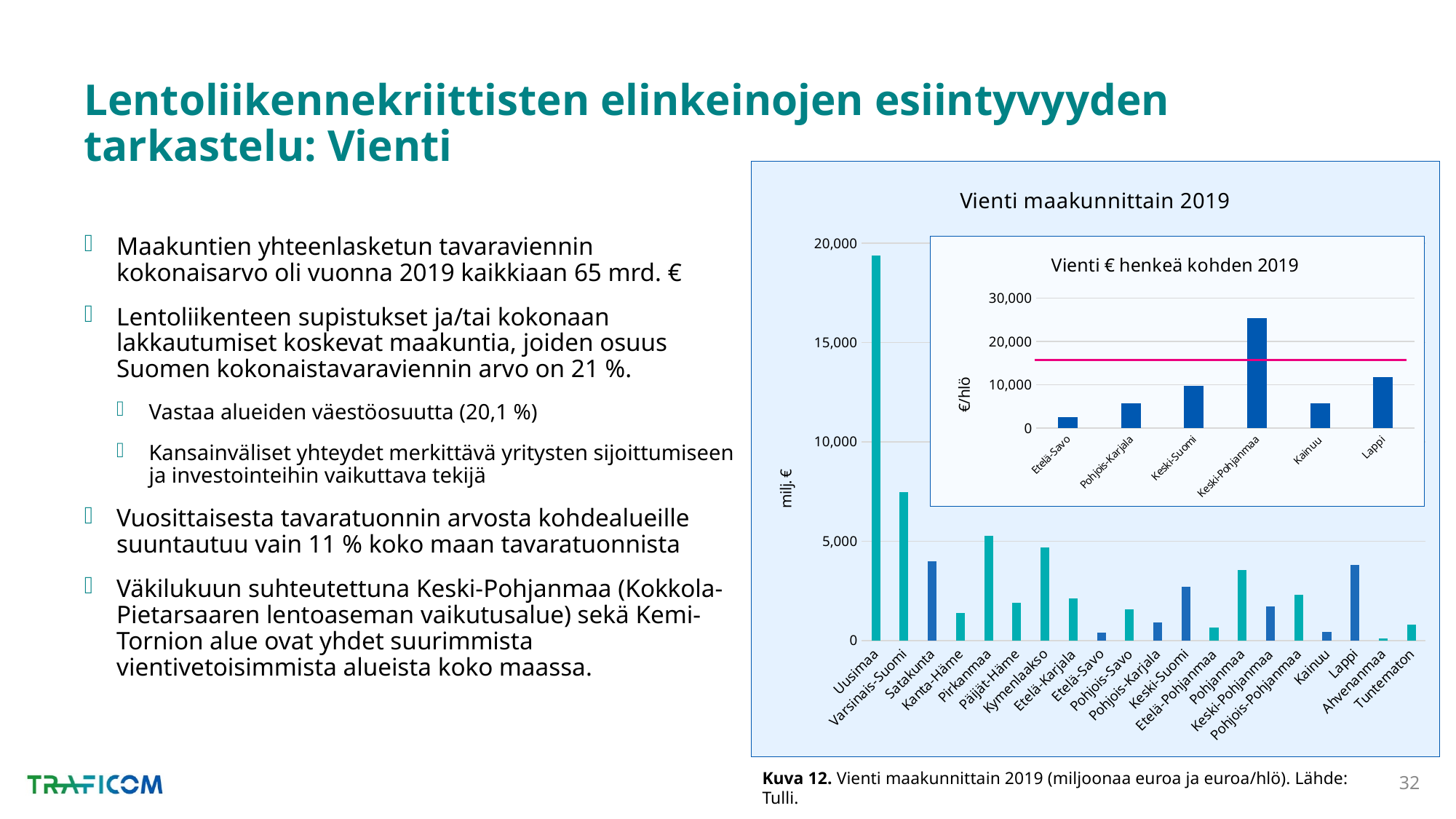
In the chart titled 'Vienti maakunnittain 2019', is the value for Varsinais-Suomi greater or less than 5,000? greater In the chart titled 'Vienti maakunnittain 2019', which region has the lowest value? Ahvenanmaa How many regions are shown in the inset chart titled 'Vienti € henkeä kohden 2019'? 6 What kind of chart is 'Vienti maakunnittain 2019'? bar chart In the inset chart titled 'Vienti € henkeä kohden 2019', which region has the highest value? Keski-Pohjanmaa In the chart titled 'Vienti maakunnittain 2019', which region has the highest value? Uusimaa In the chart titled 'Vienti maakunnittain 2019', is the value for Uusimaa greater or less than 15,000? greater In the inset chart titled 'Vienti € henkeä kohden 2019', is the value for Keski-Pohjanmaa greater or less than 20,000? greater How many regions (categories) are shown on the x axis of the chart titled 'Vienti maakunnittain 2019'? 20 What is the y-axis label of the chart titled 'Vienti maakunnittain 2019'? milj. € In the chart titled 'Vienti maakunnittain 2019', which is larger, the value for Lappi or the value for Kainuu? Lappi